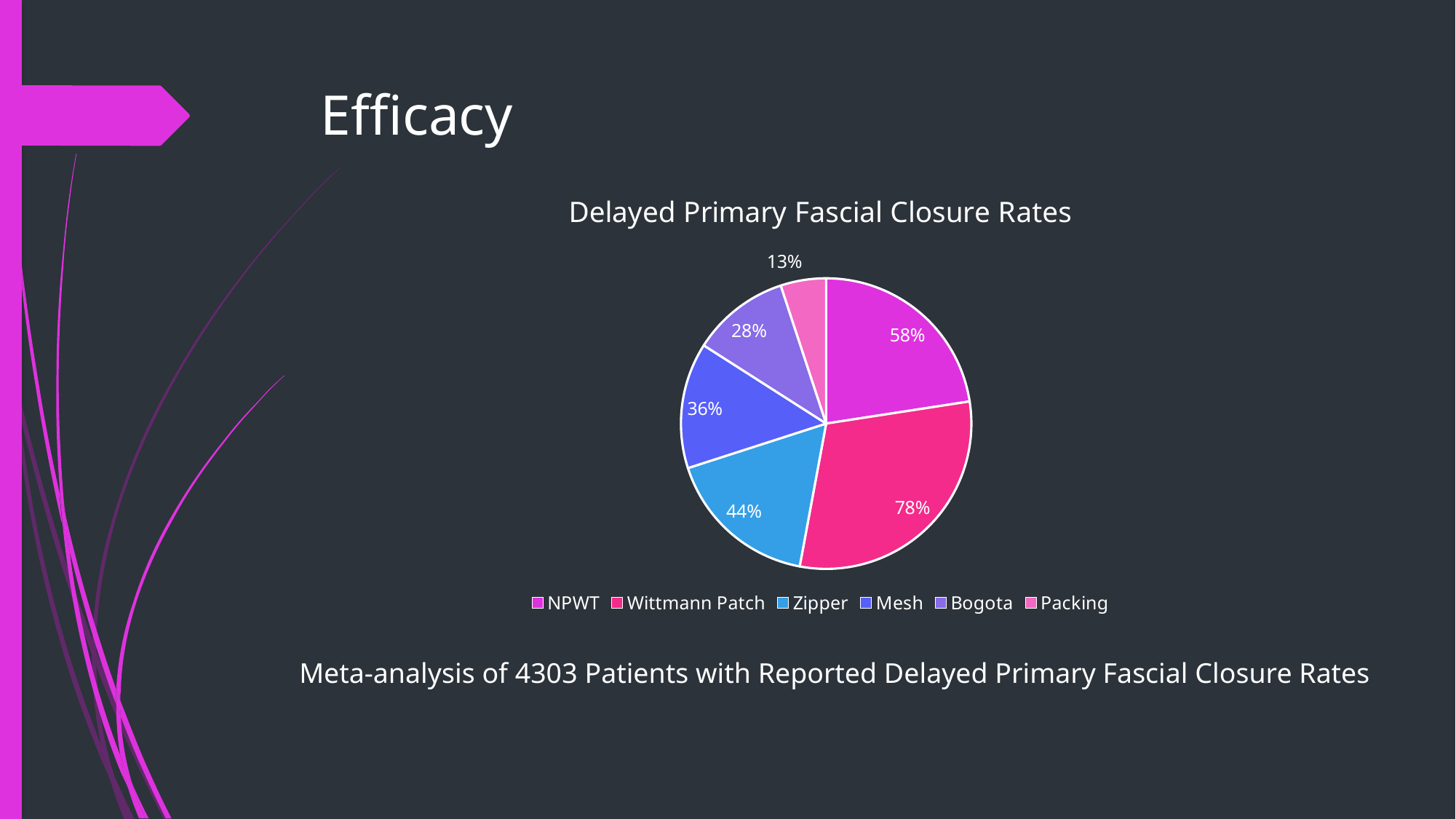
What value is labelled on the Wittmann Patch slice? 78% Which category has the highest labelled value? Wittmann Patch What value is labelled on the NPWT slice? 58% What is the title of the chart? Delayed Primary Fascial Closure Rates What value is labelled on the Zipper slice? 44% What is the difference between the labelled values for Wittmann Patch and NPWT? 20% How many categories does the legend list? 6 Which category has the lowest labelled value? Packing What value is labelled on the Packing slice? 13% What type of chart is shown on the slide? pie chart Which has the larger labelled value, Zipper or Bogota? Zipper What value is labelled on the Mesh slice? 36%